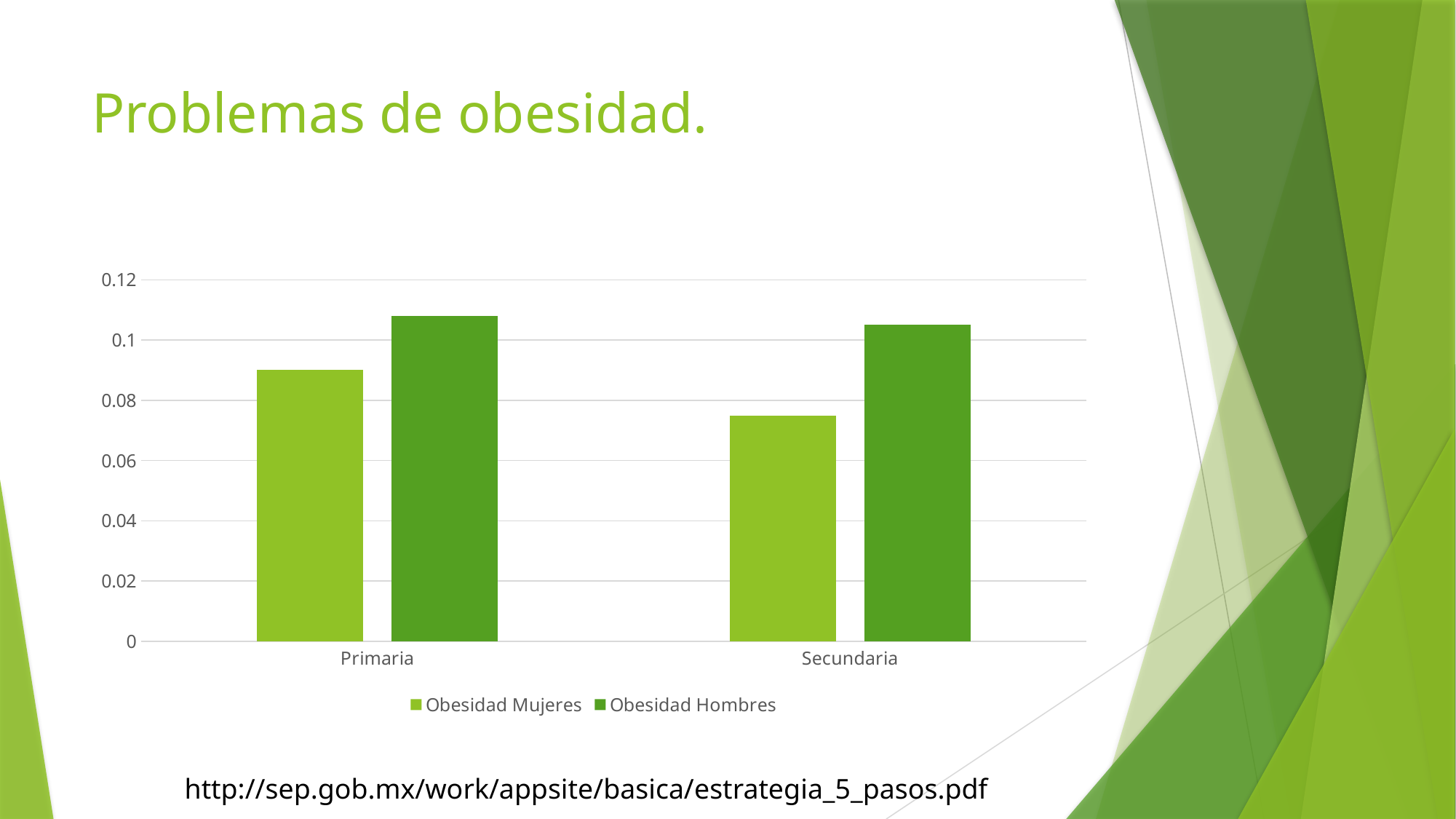
For the Obesidad Mujeres series, which category has the higher value? Primaria Is the Obesidad Mujeres value for Secundaria greater or less than 0.08? less In the Primaria category, which is larger: Obesidad Mujeres or Obesidad Hombres? Obesidad Hombres Is the Obesidad Hombres value for Primaria greater or less than 0.1? greater Is the Obesidad Mujeres value for Primaria greater or less than 0.08? greater Does the Obesidad Mujeres value rise or fall from Primaria to Secundaria? fall Which series has the lowest bar in the chart, and for which category? Obesidad Mujeres, Secundaria In the Secundaria category, which is larger: Obesidad Mujeres or Obesidad Hombres? Obesidad Hombres What kind of chart is shown on the slide? bar chart What is the title of the slide containing the chart? Problemas de obesidad. How many series does the legend list? 2 How many categories are shown on the x axis? 2